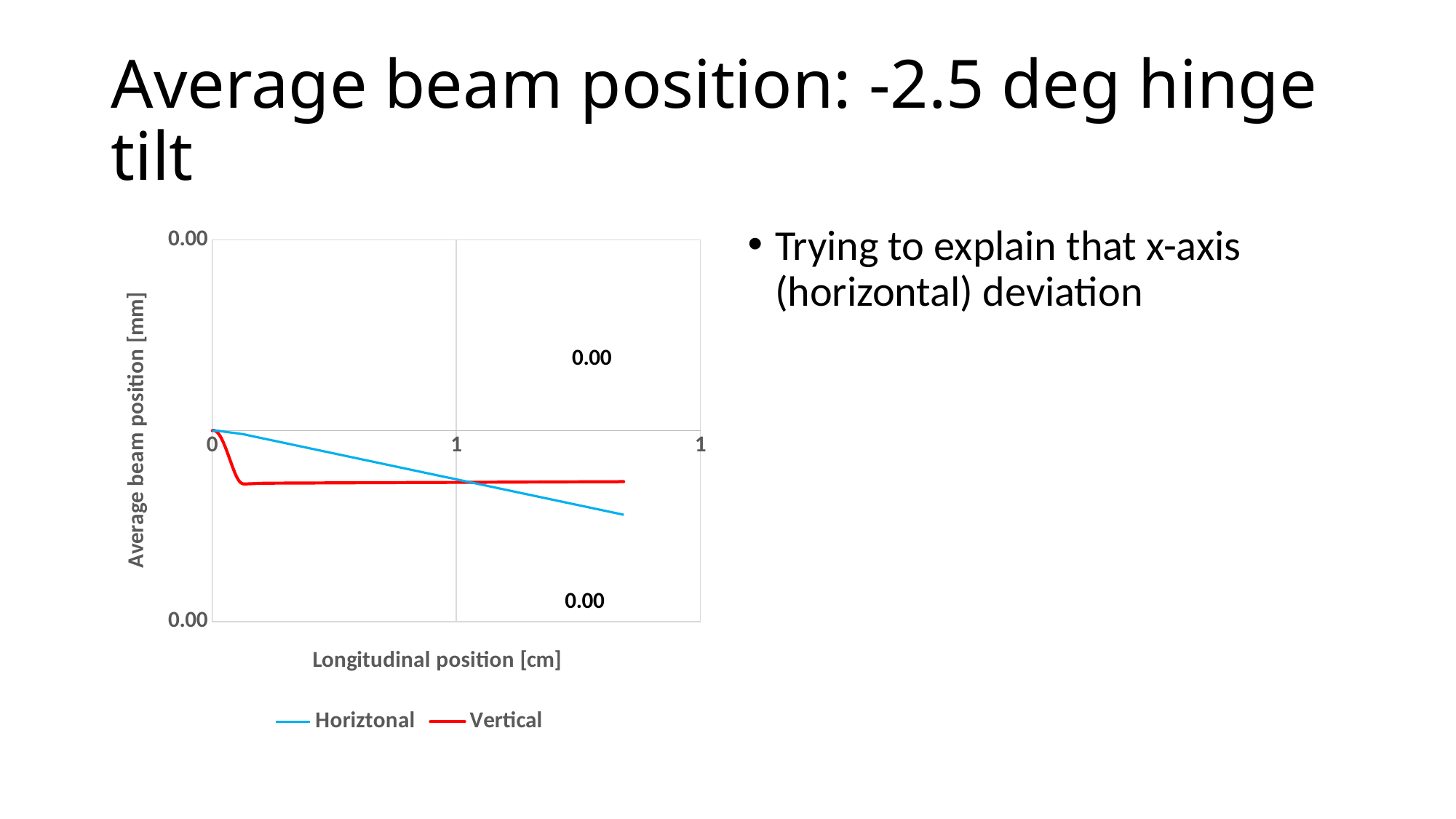
Which series is drawn in blue? Horiztonal Which series is drawn in red? Vertical What are the two series named in the legend? Horiztonal and Vertical How many series does the legend list? 2 What kind of chart is shown on the slide? line chart Does the Horiztonal line rise or fall from left to right across the chart? fall